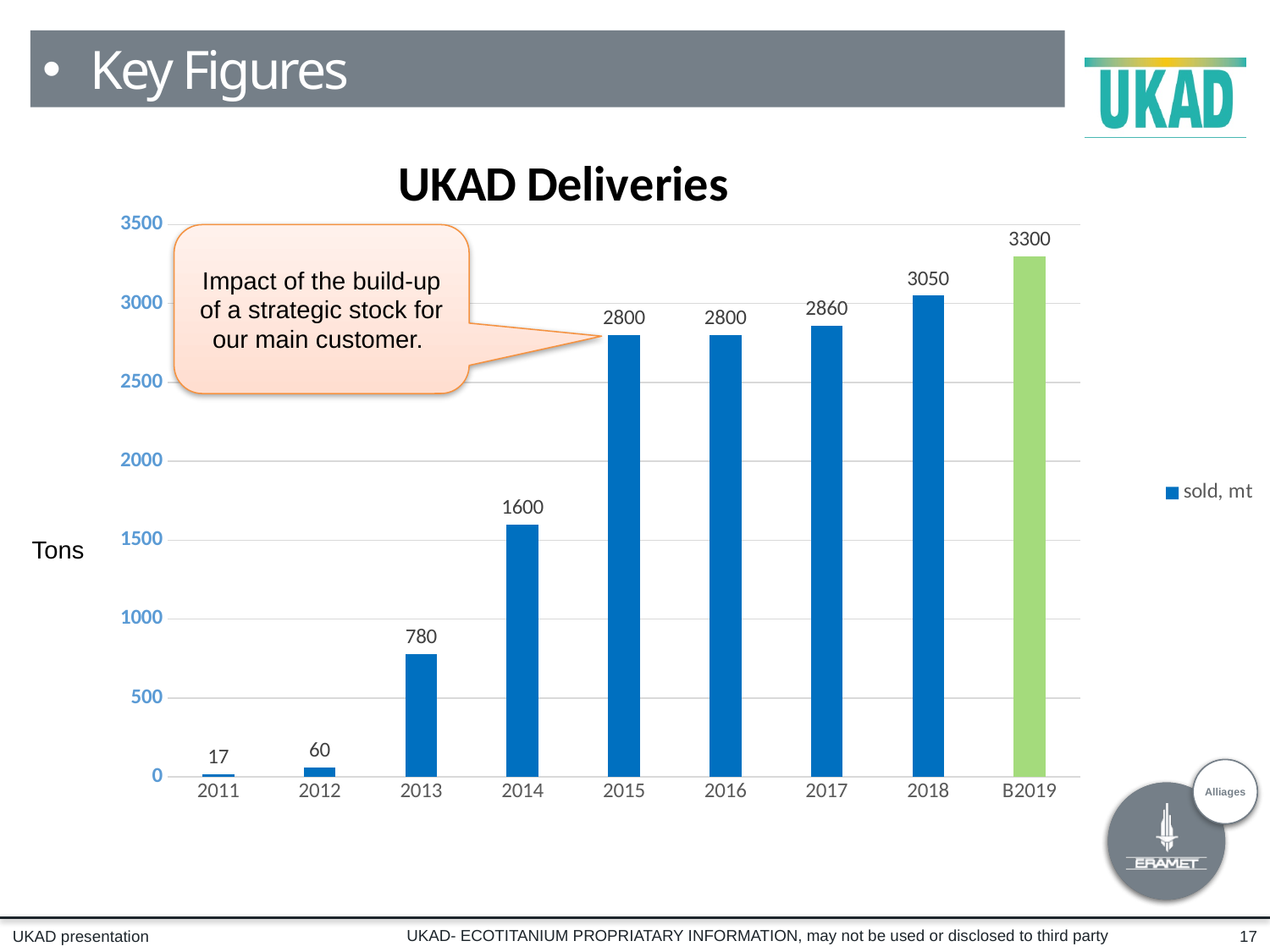
Is the value for 2015 greater or less than 2500 in the UKAD Deliveries chart? greater Which category has the highest value in the UKAD Deliveries chart? B2019 What is the difference between the values for 2018 and 2017 in the UKAD Deliveries chart? 190 What is the value for B2019 in the UKAD Deliveries chart? 3300 What is the value for 2014 in the UKAD Deliveries chart? 1600 What is the difference between the values for 2014 and 2013 in the UKAD Deliveries chart? 820 What kind of chart is the UKAD Deliveries chart? bar chart What is the value for 2017 in the UKAD Deliveries chart? 2860 Which is larger in the UKAD Deliveries chart, the value for 2013 or the value for 2012? 2013 What series does the legend of the UKAD Deliveries chart list? sold, mt How many categories are shown on the x axis of the UKAD Deliveries chart? 9 Which category has the lowest value in the UKAD Deliveries chart? 2011